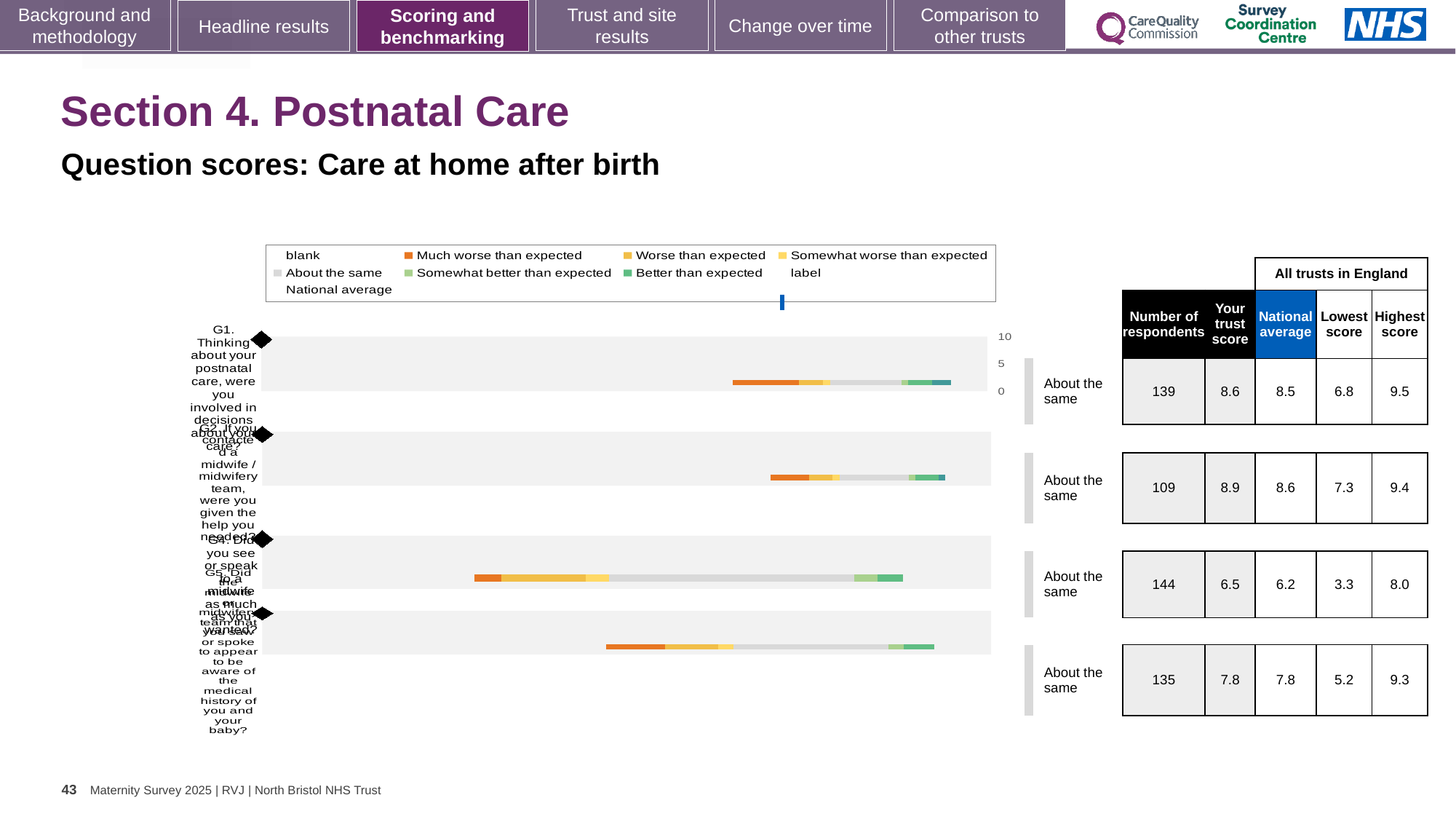
Which question has the lowest trust score? G4 What is the trust score for question G1 (involved in decisions about postnatal care)? 8.6 Which has the larger trust score, question G1 or question G5? G1 What is the highest score across all trusts in England for question G1? 9.5 What is the difference between the trust score and the national average for question G2? 0.3 How many questions (bars) are plotted in the chart? 4 Which question has the highest trust score? G2 What is the national average for question G2 (given the help you needed when contacting a midwife)? 8.6 What is the number of respondents for question G4 (see or speak to a midwife as much as you wanted)? 144 What benchmark category is shown for question G5 (midwife aware of medical history)? About the same What kind of chart is shown on the slide? bar chart What is the difference between the highest score and the lowest score across all trusts for question G4? 4.7